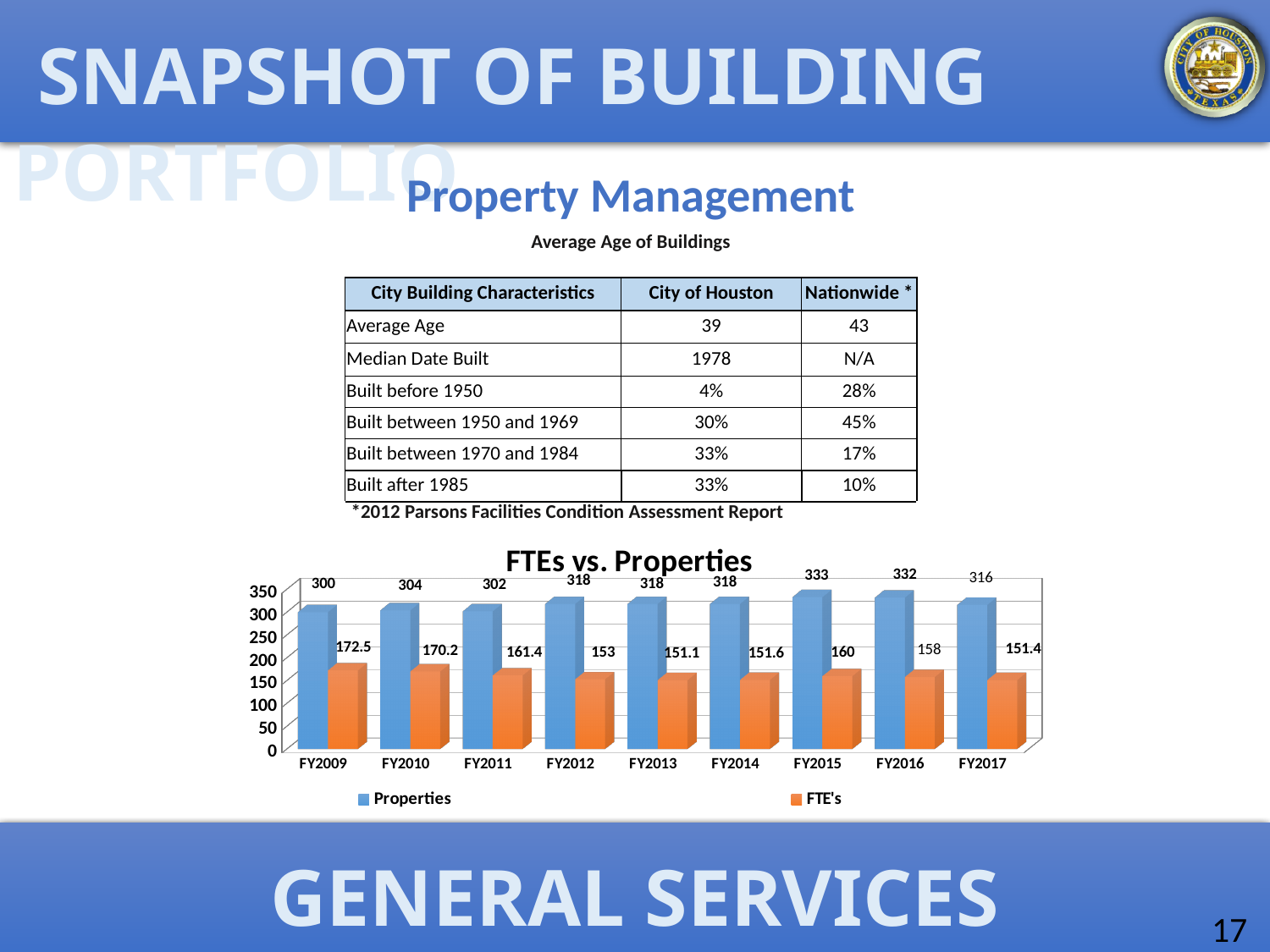
Which is larger in the "FTEs vs. Properties" chart: FTE's in FY2010 or FTE's in FY2013? FY2010 What is the value for FTE's in FY2009 in the "FTEs vs. Properties" chart? 172.5 Which colour represents the FTE's series in the "FTEs vs. Properties" chart? orange In which fiscal year is the FTE's value highest in the "FTEs vs. Properties" chart? FY2009 What is the value for Properties in FY2015 in the "FTEs vs. Properties" chart? 333 What is the value for FTE's in FY2017 in the "FTEs vs. Properties" chart? 151.4 How many series does the legend of the "FTEs vs. Properties" chart list? 2 What is the difference between the Properties value in FY2015 and in FY2009 in the "FTEs vs. Properties" chart? 33 In which fiscal year is the Properties value lowest in the "FTEs vs. Properties" chart? FY2009 How many fiscal years are shown on the x axis of the "FTEs vs. Properties" chart? 9 In which fiscal year is the Properties value highest in the "FTEs vs. Properties" chart? FY2015 What kind of chart is "FTEs vs. Properties"? bar chart